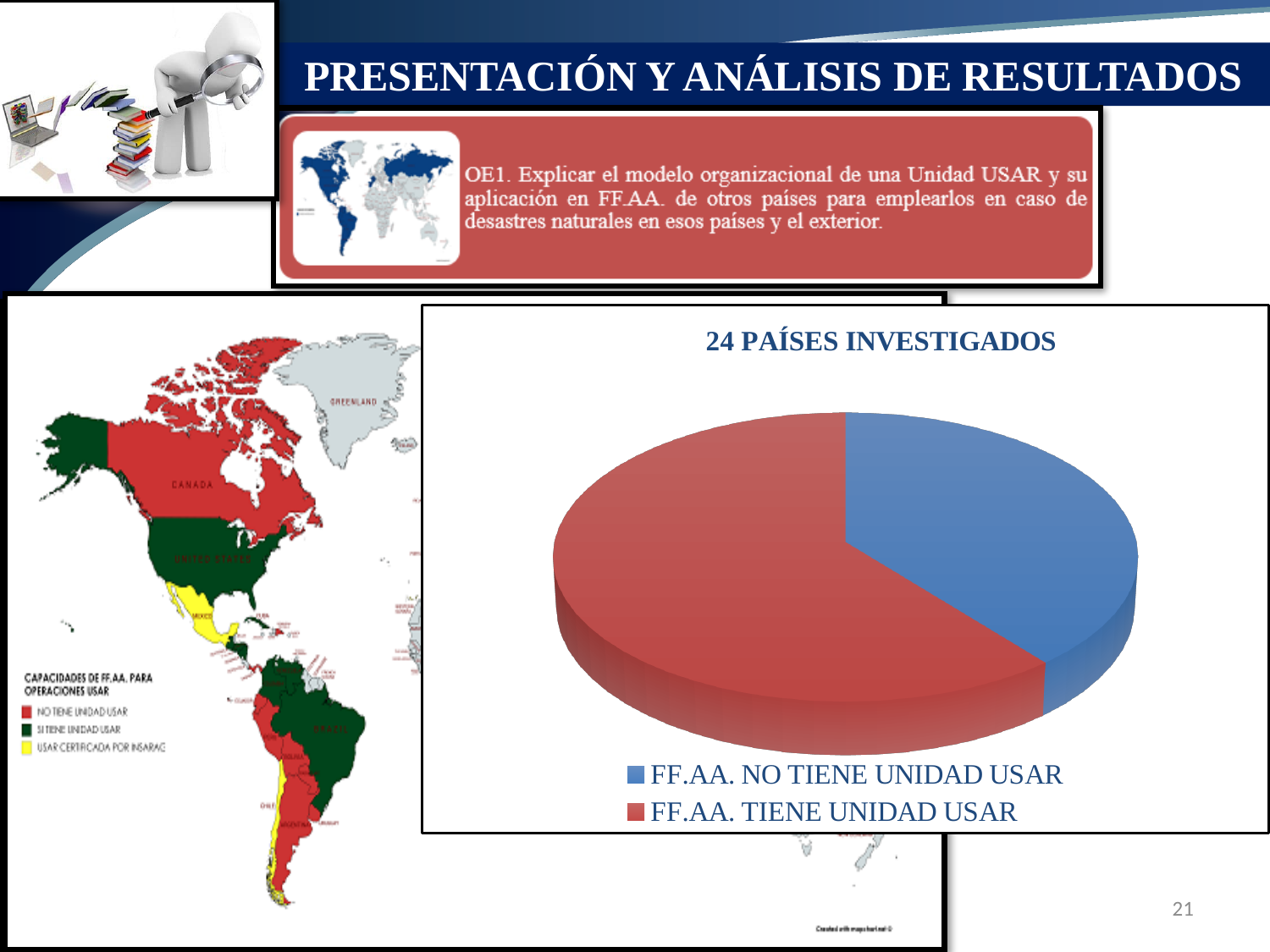
What colour is the slice for "FF.AA. NO TIENE UNIDAD USAR" in the pie chart? Blue How many slices does the pie chart have? 2 In the pie chart, which is larger: the slice for "FF.AA. TIENE UNIDAD USAR" or the slice for "FF.AA. NO TIENE UNIDAD USAR"? FF.AA. TIENE UNIDAD USAR What kind of chart is shown under the title "24 PAÍSES INVESTIGADOS"? Pie chart What is the title of the pie chart on the slide? 24 PAÍSES INVESTIGADOS Which category takes up the largest share of the pie chart? FF.AA. TIENE UNIDAD USAR How many entries does the pie chart's legend list? 2 Which category takes up the smallest share of the pie chart? FF.AA. NO TIENE UNIDAD USAR